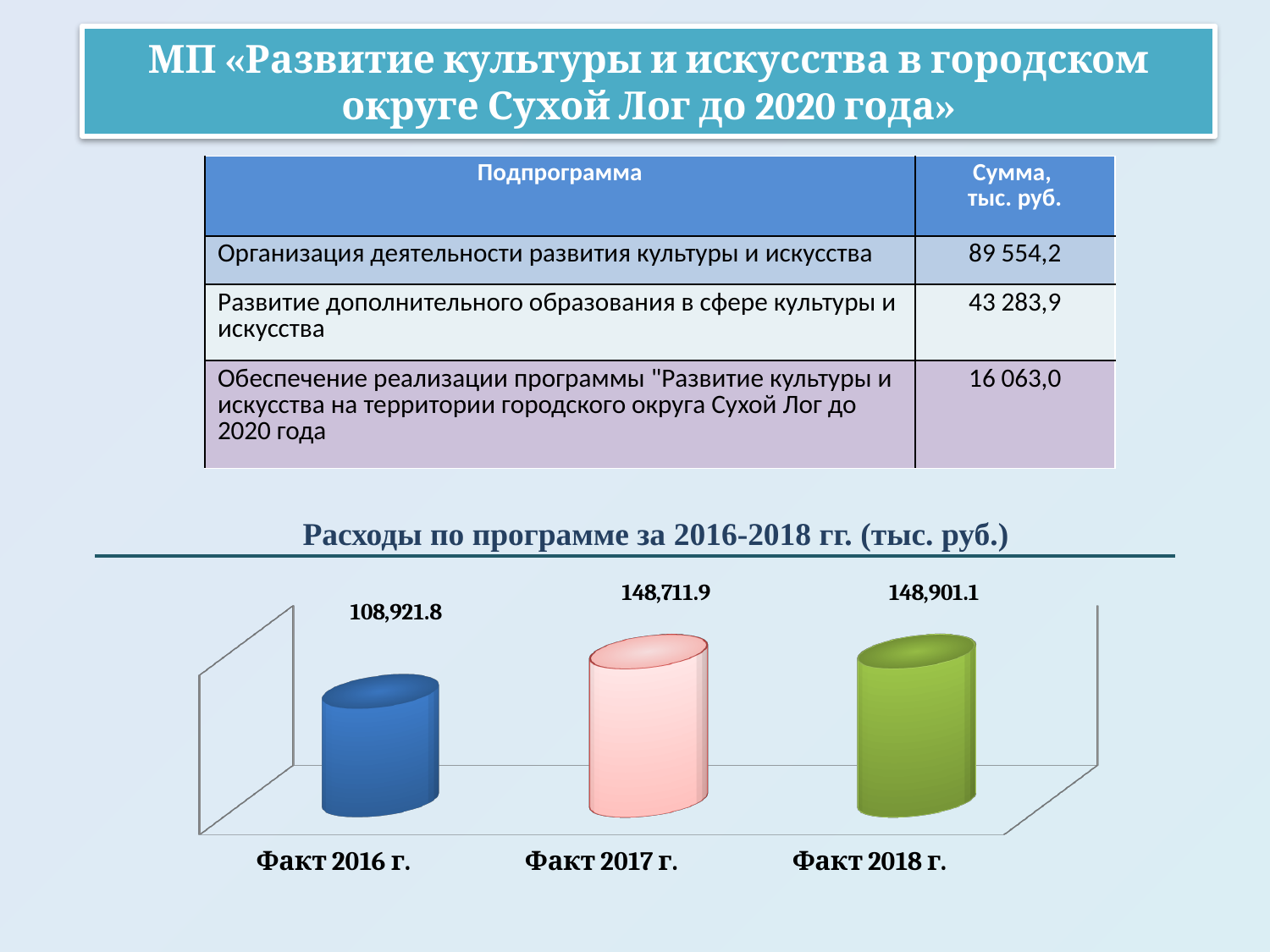
Which category has the lowest value in the chart? Факт 2016 г. What is the difference between the values for Факт 2018 г. and Факт 2017 г.? 189.2 What is the value for Факт 2016 г. in the chart? 108,921.8 Which category has the highest value in the chart? Факт 2018 г. Do the values rise or fall from Факт 2016 г. to Факт 2018 г.? Rise What is the value for Факт 2018 г. in the chart? 148,901.1 What is the title of the chart? Расходы по программе за 2016-2018 гг. (тыс. руб.) What is the difference between the values for Факт 2017 г. and Факт 2016 г.? 39,790.1 How many categories are shown in the chart? 3 What is the value for Факт 2017 г. in the chart? 148,711.9 What kind of chart is shown on the slide? Bar chart Which is larger, the value for Факт 2016 г. or the value for Факт 2017 г.? Факт 2017 г.